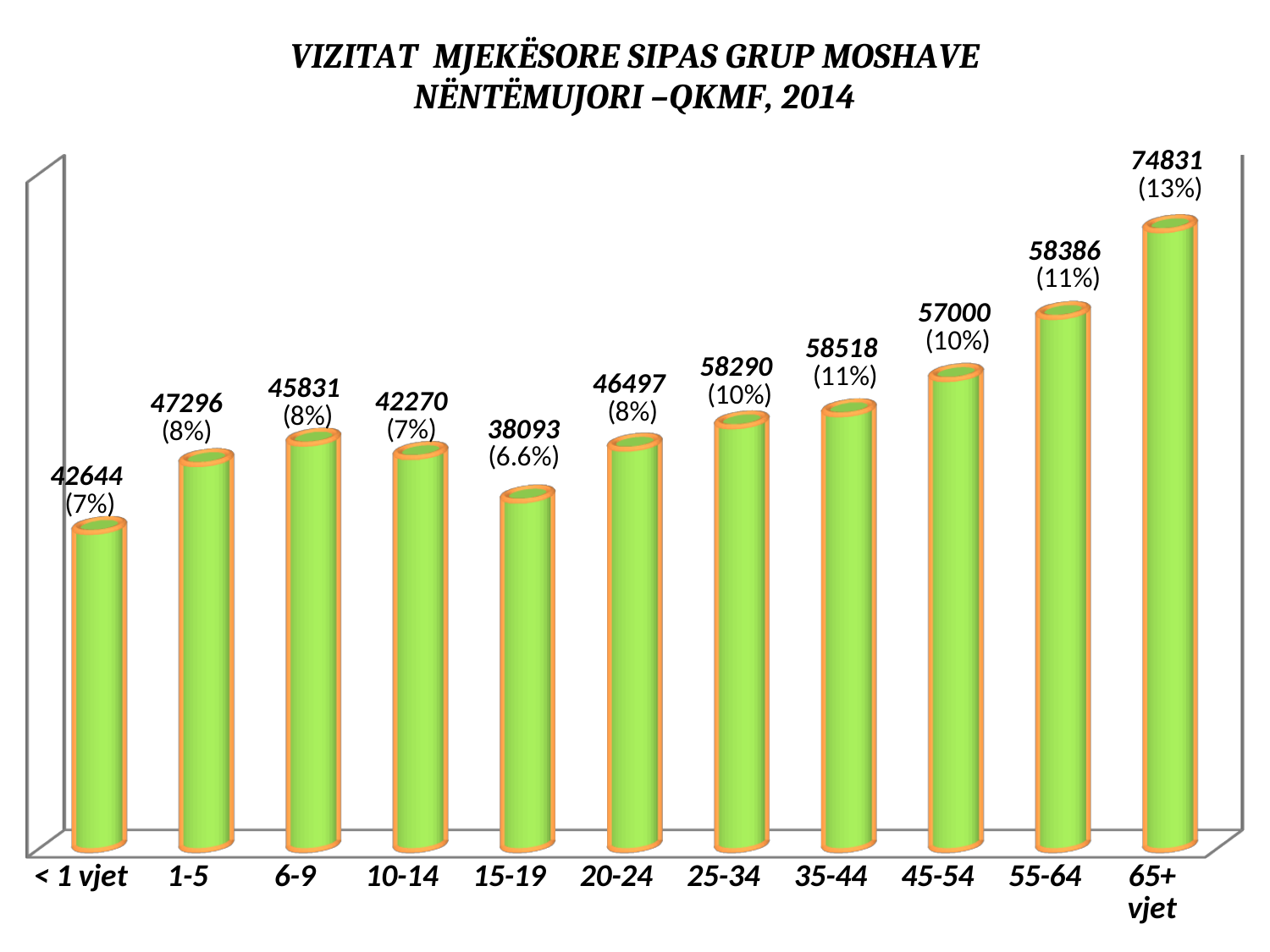
What percentage share is shown for the 15-19 age group? 6.6% Which age group has the highest number of medical visits? 65+ vjet What is the difference in visits between the 1-5 group and the < 1 vjet group? 4652 What is the number of medical visits for the 45-54 age group? 57000 What is the number of medical visits for the 15-19 age group? 38093 What percentage share is shown for the 65+ vjet age group? 13% How many age groups are shown on the chart? 11 What kind of chart is shown on the slide? bar chart What is the title of the chart? VIZITAT MJEKËSORE SIPAS GRUP MOSHAVE NËNTËMUJORI –QKMF, 2014 Which has more visits, the 6-9 group or the 20-24 group? 20-24 Which age group has the lowest number of medical visits? 15-19 What is the difference in visits between the 65+ vjet group and the 55-64 group? 16445